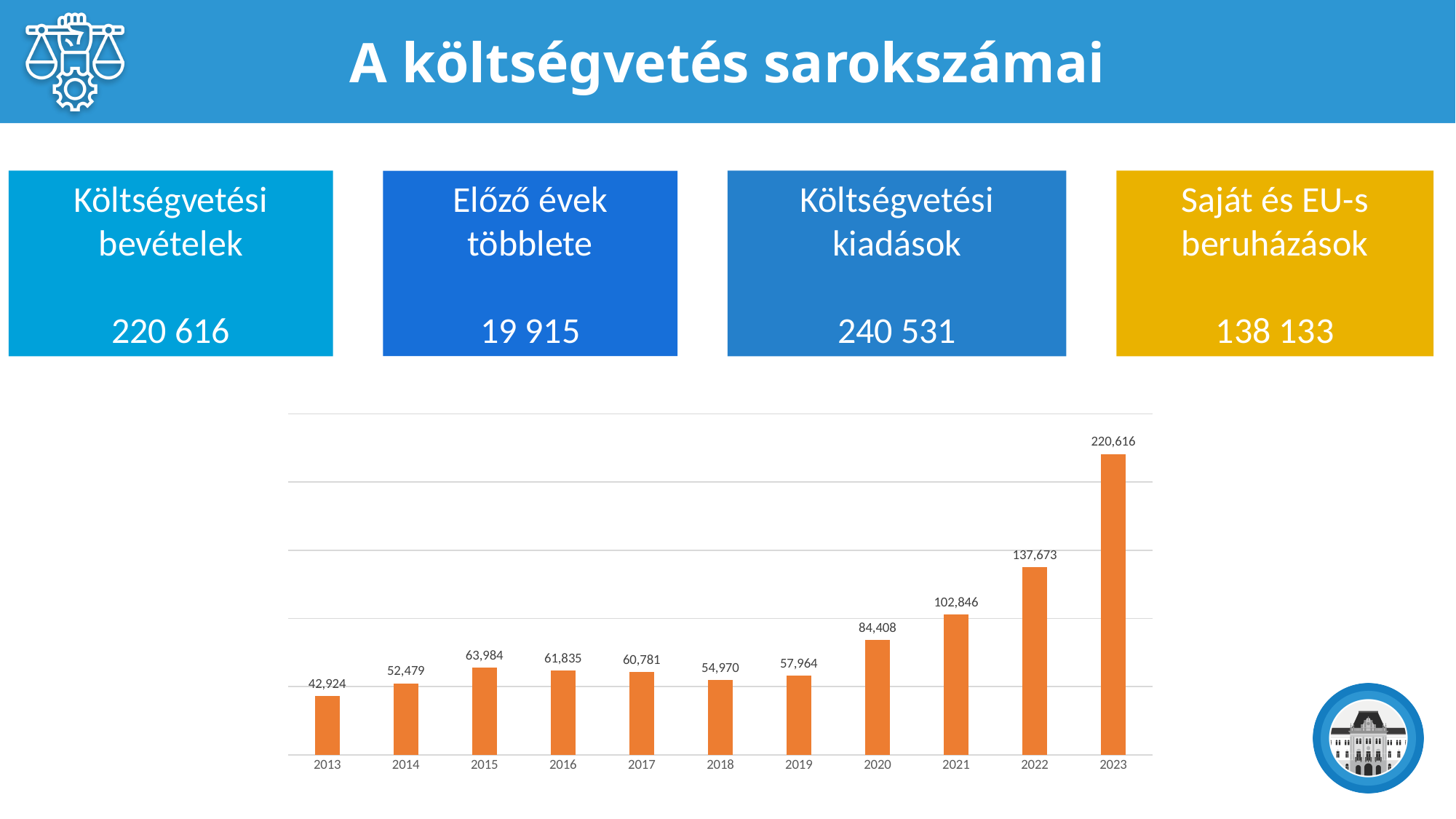
Which year has the lowest value in the bar chart? 2013 Do the values in the bar chart rise or fall from 2019 to 2023? rise Which year has the larger value in the bar chart, 2019 or 2022? 2022 What is the value shown for 2017 in the bar chart? 60,781 How many years are shown on the x axis of the bar chart? 11 What is the difference between the values for 2021 and 2020 in the bar chart? 18,438 What is the difference between the values for 2023 and 2022 in the bar chart? 82,943 Which year has the highest value in the bar chart? 2023 Which year has the larger value in the bar chart, 2015 or 2018? 2015 What is the value shown for 2023 in the bar chart? 220,616 What kind of chart is shown on the slide? bar chart What is the value shown for 2020 in the bar chart? 84,408